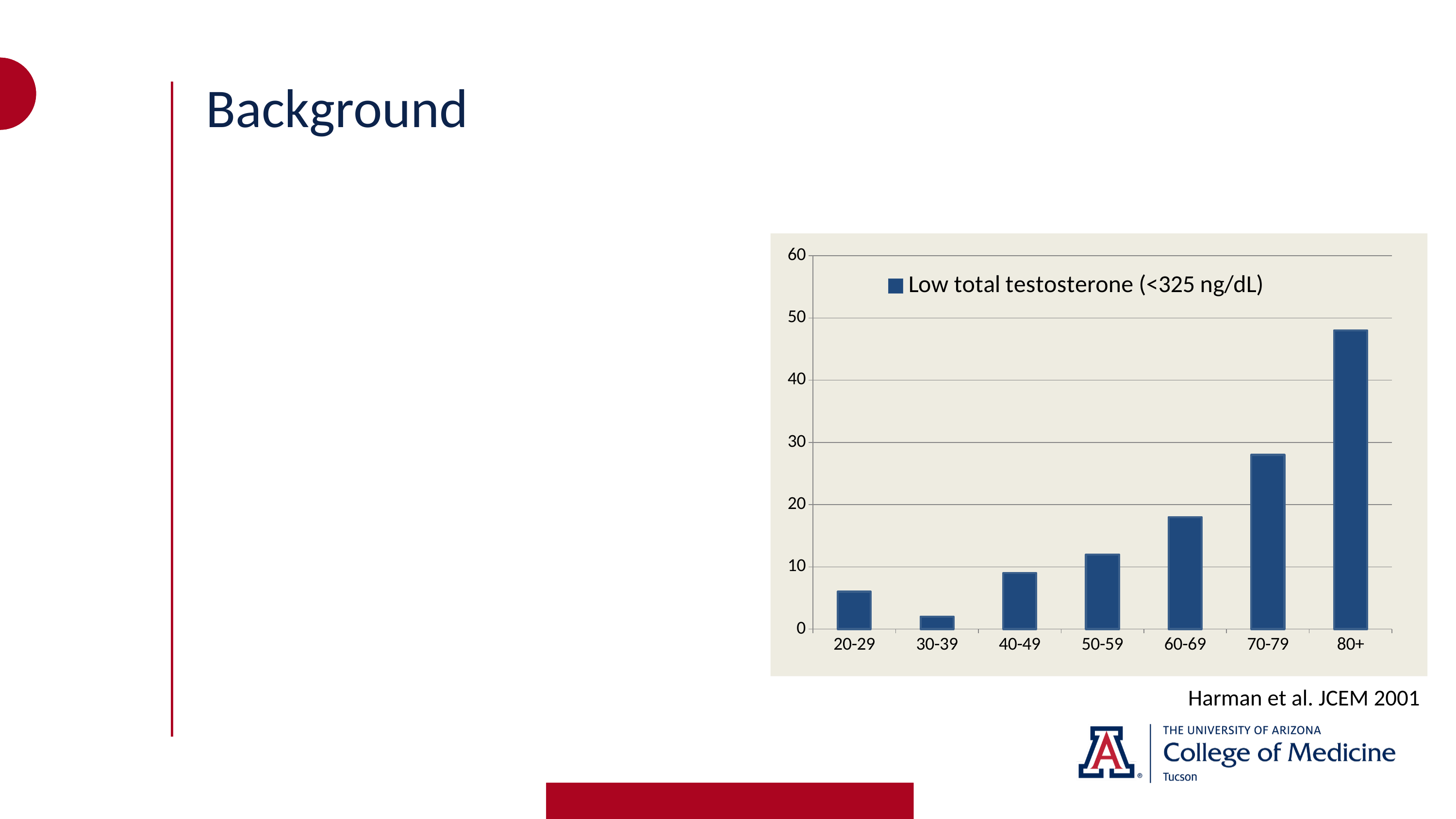
Which age group has the highest value in the chart? 80+ What is the legend entry for the series plotted in the chart? Low total testosterone (<325 ng/dL) Which age group has the lowest value in the chart? 30-39 Which age group has a larger value, 50-59 or 70-79? 70-79 What kind of chart is shown on the slide? bar chart How many age groups are shown on the x axis of the chart? 7 From the 30-39 age group onward, do the values rise or fall as age increases? rise Is the value for the 60-69 age group greater or less than 10? greater Is the value for the 30-39 age group greater or less than 10? less How many series does the chart's legend list? 1 Is the value for the 80+ age group greater or less than 40? greater